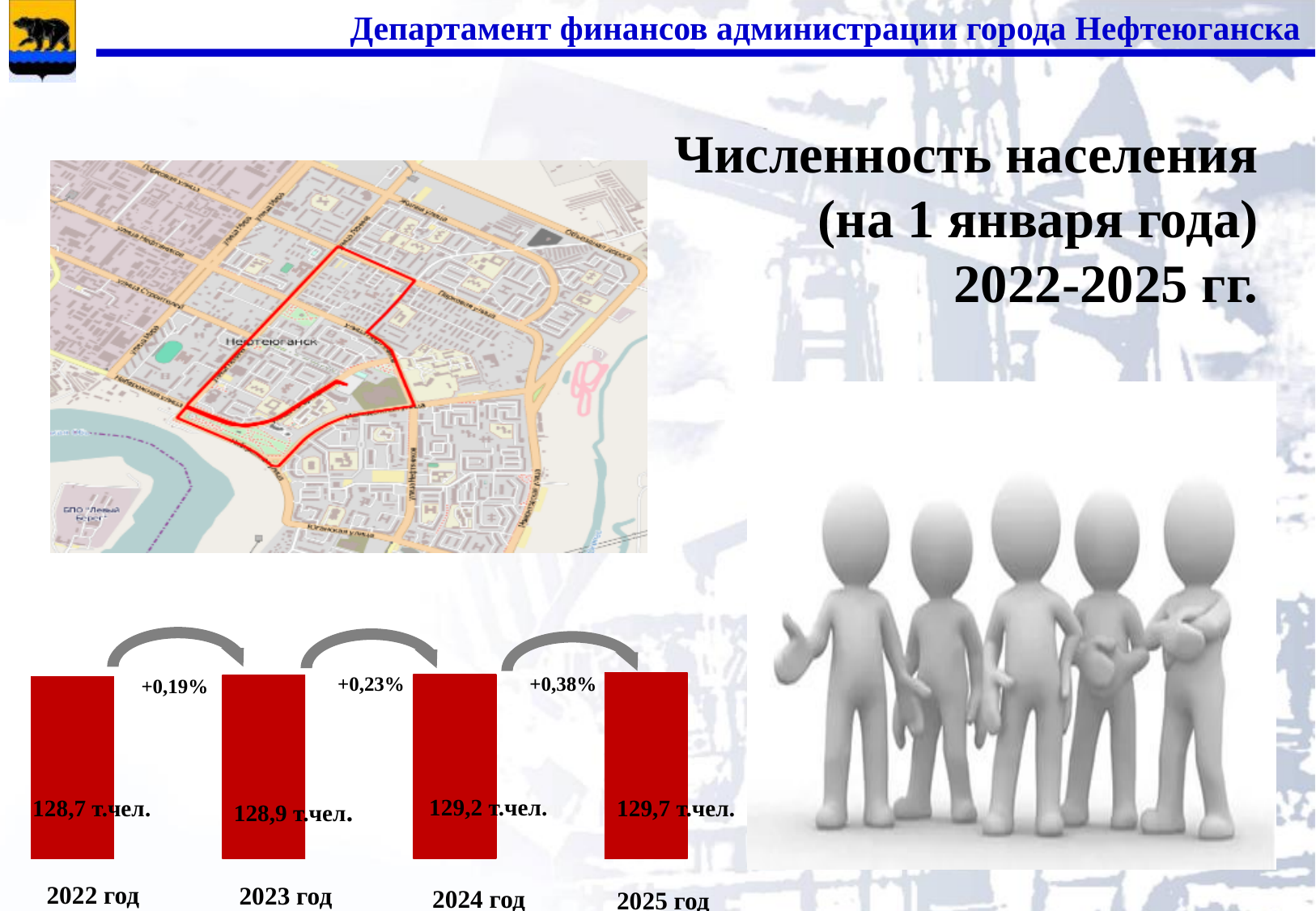
What is the population value shown for 2024 год? 129,2 т.чел. What kind of chart is used to show the population figures? bar chart Which is larger, the population value for 2023 год or for 2024 год? 2024 год What percentage change is shown between 2024 год and 2025 год? +0,38% What is the population value shown for 2025 год? 129,7 т.чел. What is the population value shown for 2022 год? 128,7 т.чел. What is the difference between the population values for 2025 год and 2022 год? 1,0 т.чел. What percentage change is shown between 2023 год and 2024 год? +0,23% How many years (bars) are shown in the chart? 4 Do the population values rise or fall from 2022 год to 2025 год? rise Which year has the highest population value in the chart? 2025 год Which year has the lowest population value in the chart? 2022 год